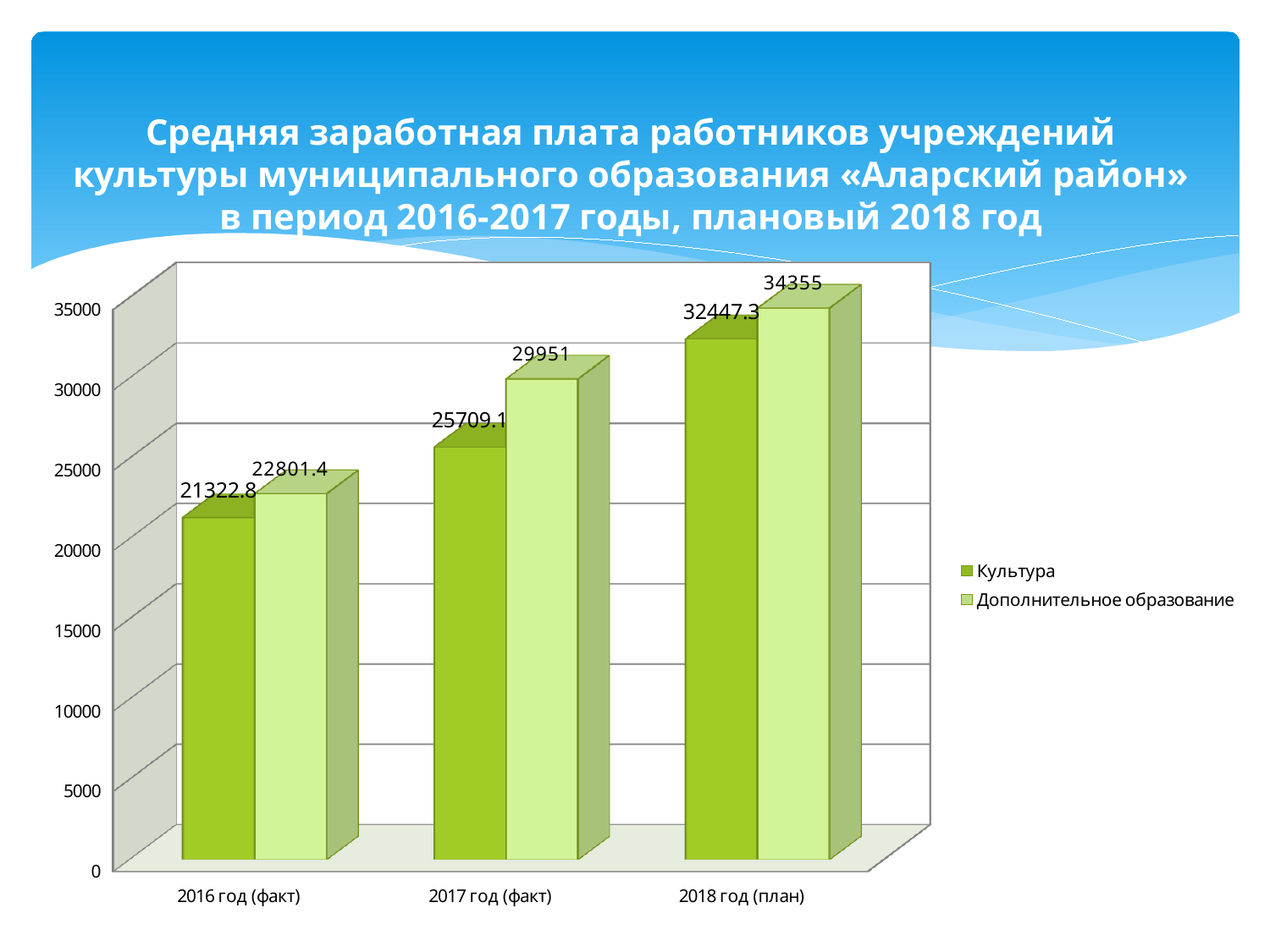
What is the difference between Дополнительное образование and Культура in 2017 год (факт)? 4241.9 How many series does the legend list? 2 Which category has the lowest value for the Дополнительное образование series? 2016 год (факт) What is the value for Дополнительное образование in 2017 год (факт)? 29951 Do the values for Культура rise or fall from 2016 год (факт) to 2018 год (план)? rise What is the value for Культура in 2016 год (факт)? 21322.8 How many categories are shown on the x axis? 3 By how much does the Культура value in 2018 год (план) exceed the Культура value in 2016 год (факт)? 11124.5 Which category has the highest value for the Культура series? 2018 год (план) What is the value for Культура in 2018 год (план)? 32447.3 What is the value for Дополнительное образование in 2018 год (план)? 34355 Which is larger in 2016 год (факт): Культура or Дополнительное образование? Дополнительное образование